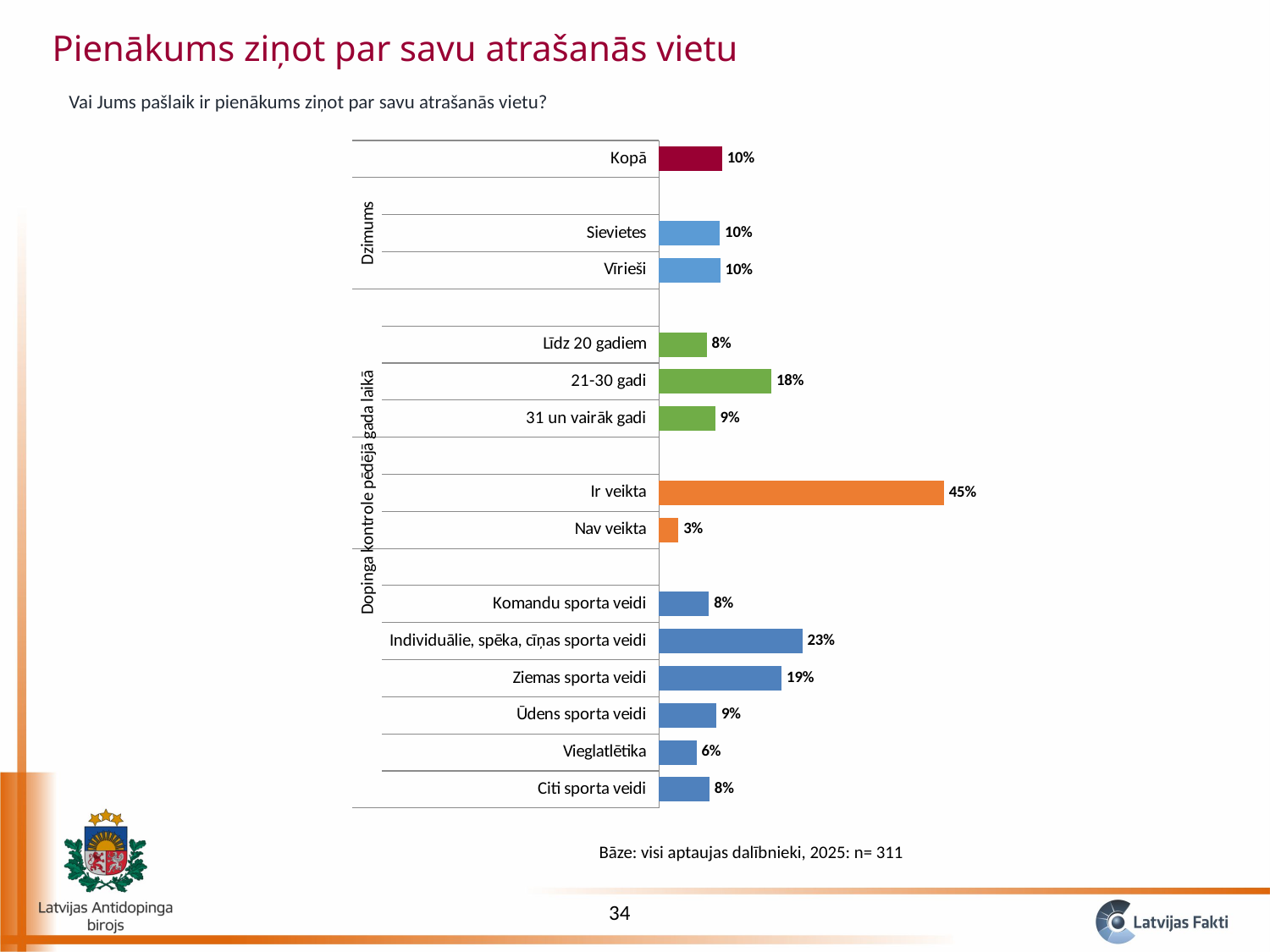
What is the value for Ziemas sporta veidi? 19% Which category has the lowest value? Nav veikta How many bars are plotted on the chart? 14 What is the value for Kopā? 10% Which category has the highest value? Ir veikta What is the difference between Individuālie, spēka, cīņas sporta veidi and Komandu sporta veidi? 15% Which is larger, the value for Vieglatlētika or the value for Ūdens sporta veidi? Ūdens sporta veidi What kind of chart is shown on the slide? Bar chart What is the value for Ir veikta? 45% What is the difference between Ir veikta and Nav veikta? 42% Which is larger, the value for 21-30 gadi or the value for Līdz 20 gadiem? 21-30 gadi What is the value for 21-30 gadi? 18%